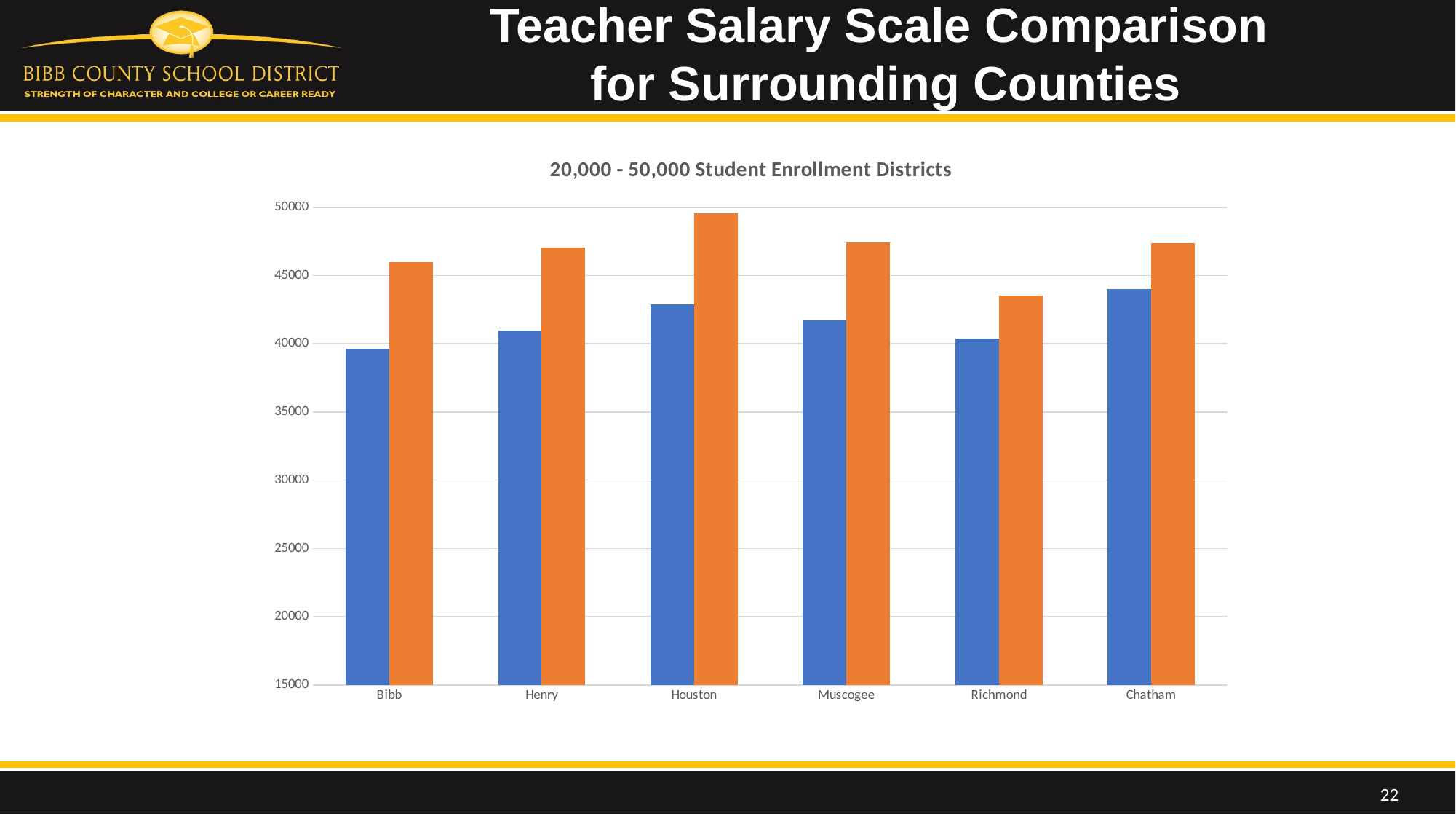
How many counties are shown on the x axis of the chart? 6 Which county has the lowest blue bar? Bibb Which county has the highest blue bar? Chatham Is the value of the orange bar for Richmond greater or less than 45000? less What kind of chart is shown on the slide? bar chart What is the title of the chart? 20,000 - 50,000 Student Enrollment Districts How many bars are shown for each county in the chart? 2 Is the value of the blue bar for Bibb greater or less than 40000? less Which is larger, the orange bar for Houston or the orange bar for Chatham? Houston Which county has the highest orange bar? Houston Which county has the lowest orange bar? Richmond Is the value of the orange bar for Bibb greater or less than 45000? greater